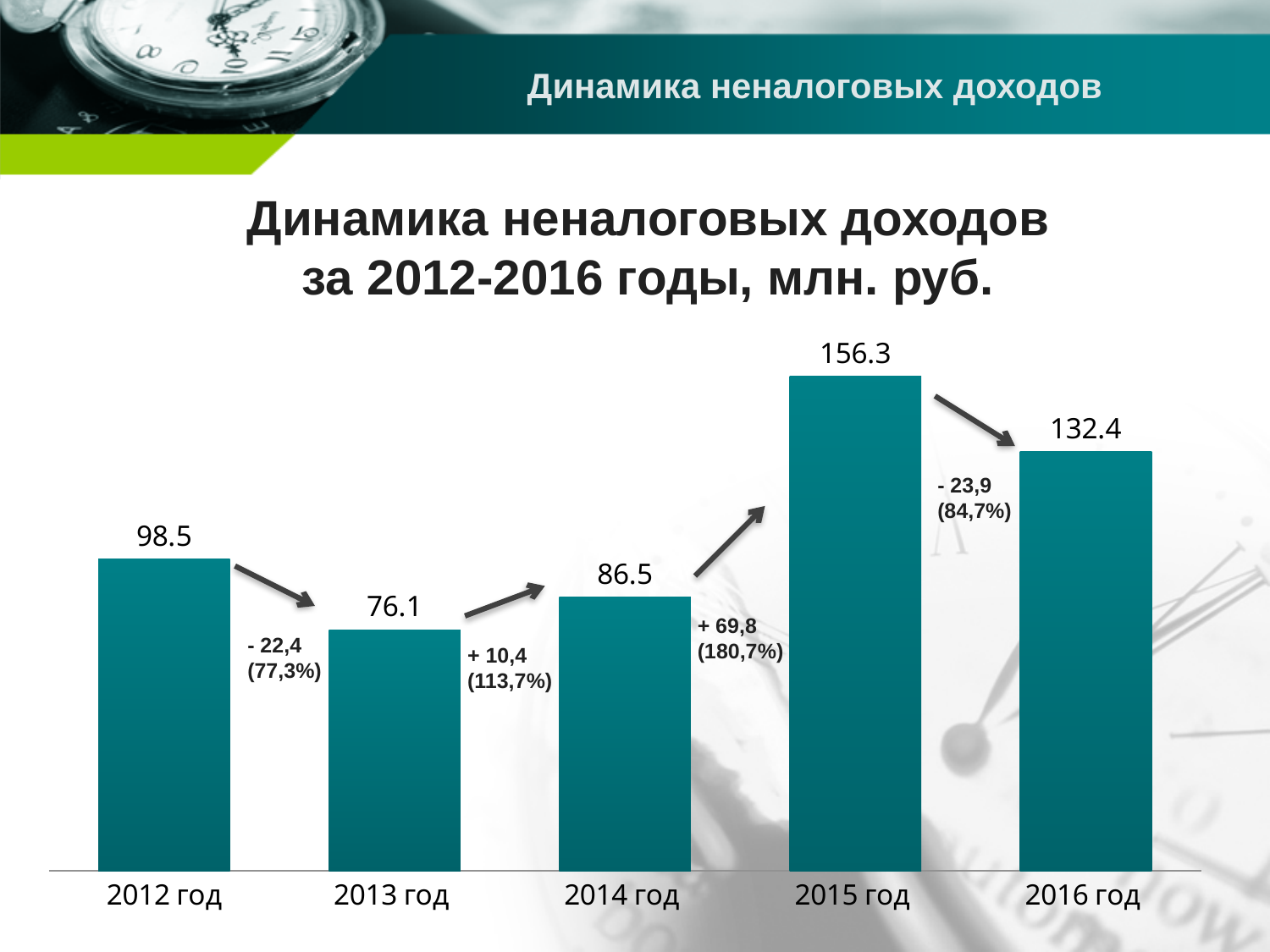
What is the value for 2012 год? 98.5 What is the title of the chart? Динамика неналоговых доходов за 2012-2016 годы, млн. руб. What is the value for 2016 год? 132.4 Does the value rise or fall from 2013 год to 2015 год? rise Which is larger, the value for 2012 год or the value for 2014 год? 2012 год How many years are shown on the chart? 5 Which year has the highest value? 2015 год What is the value for 2015 год? 156.3 What is the difference between the values for 2014 год and 2013 год? 10.4 What kind of chart is shown on the slide? bar chart Which year has the lowest value? 2013 год What is the difference between the values for 2015 год and 2016 год? 23.9